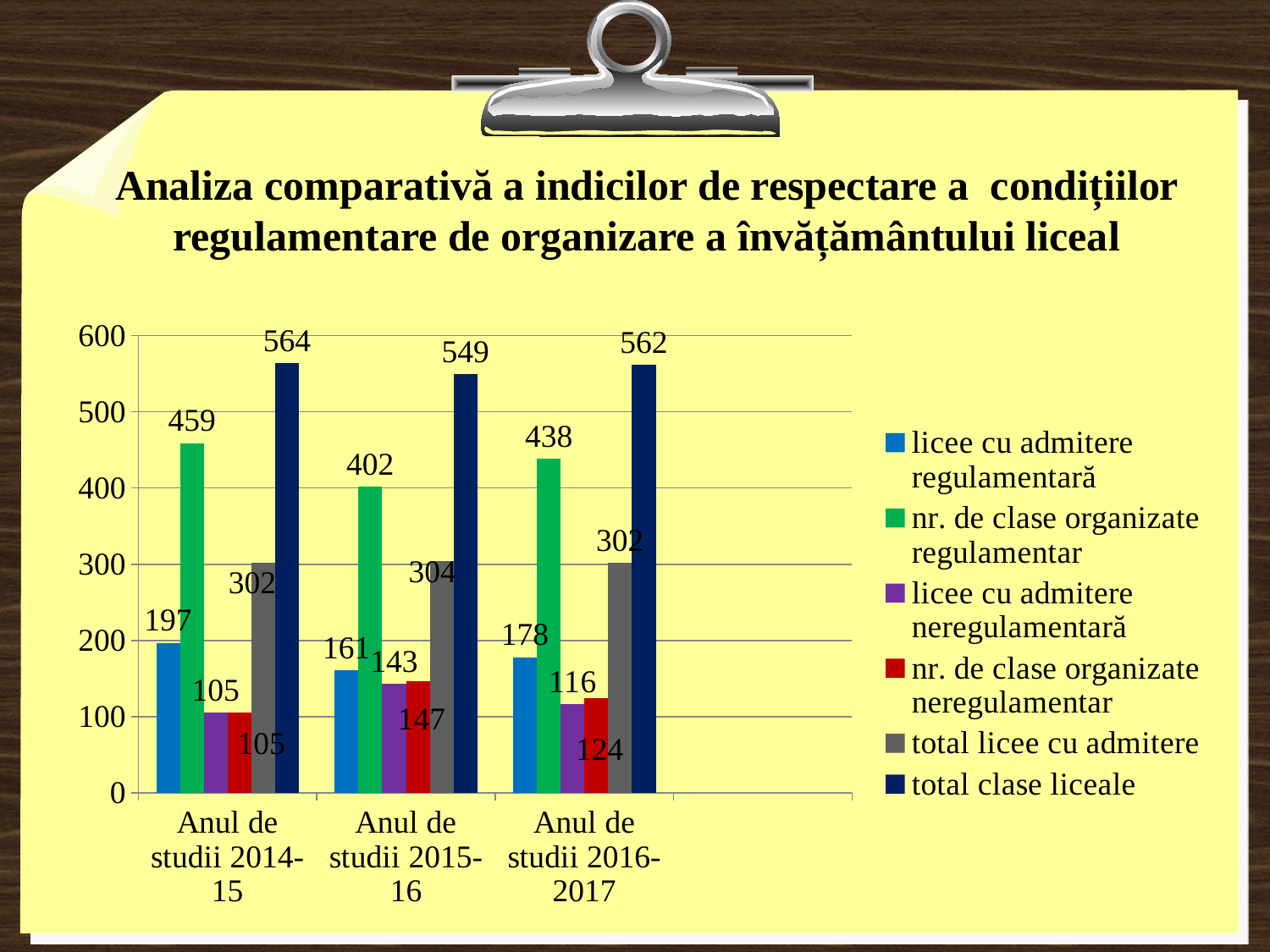
In which year is 'nr. de clase organizate regulamentar' the lowest? Anul de studii 2015-16 What is the value of 'total clase liceale' for Anul de studii 2015-16? 549 What is the value of 'nr. de clase organizate neregulamentar' for Anul de studii 2016-2017? 124 In which year is 'total clase liceale' the highest? Anul de studii 2014-15 How many series does the legend list? 6 What kind of chart is shown on the slide? bar chart How many year categories are shown on the x axis? 3 What is the value of 'licee cu admitere regulamentară' for Anul de studii 2014-15? 197 Does 'licee cu admitere regulamentară' rise or fall from Anul de studii 2014-15 to Anul de studii 2015-16? fall Which is larger: 'licee cu admitere neregulamentară' in Anul de studii 2015-16 or in Anul de studii 2016-2017? Anul de studii 2015-16 Which colour represents 'total clase liceale' in the legend? dark blue What is the difference between 'nr. de clase organizate regulamentar' in Anul de studii 2014-15 and Anul de studii 2016-2017? 21